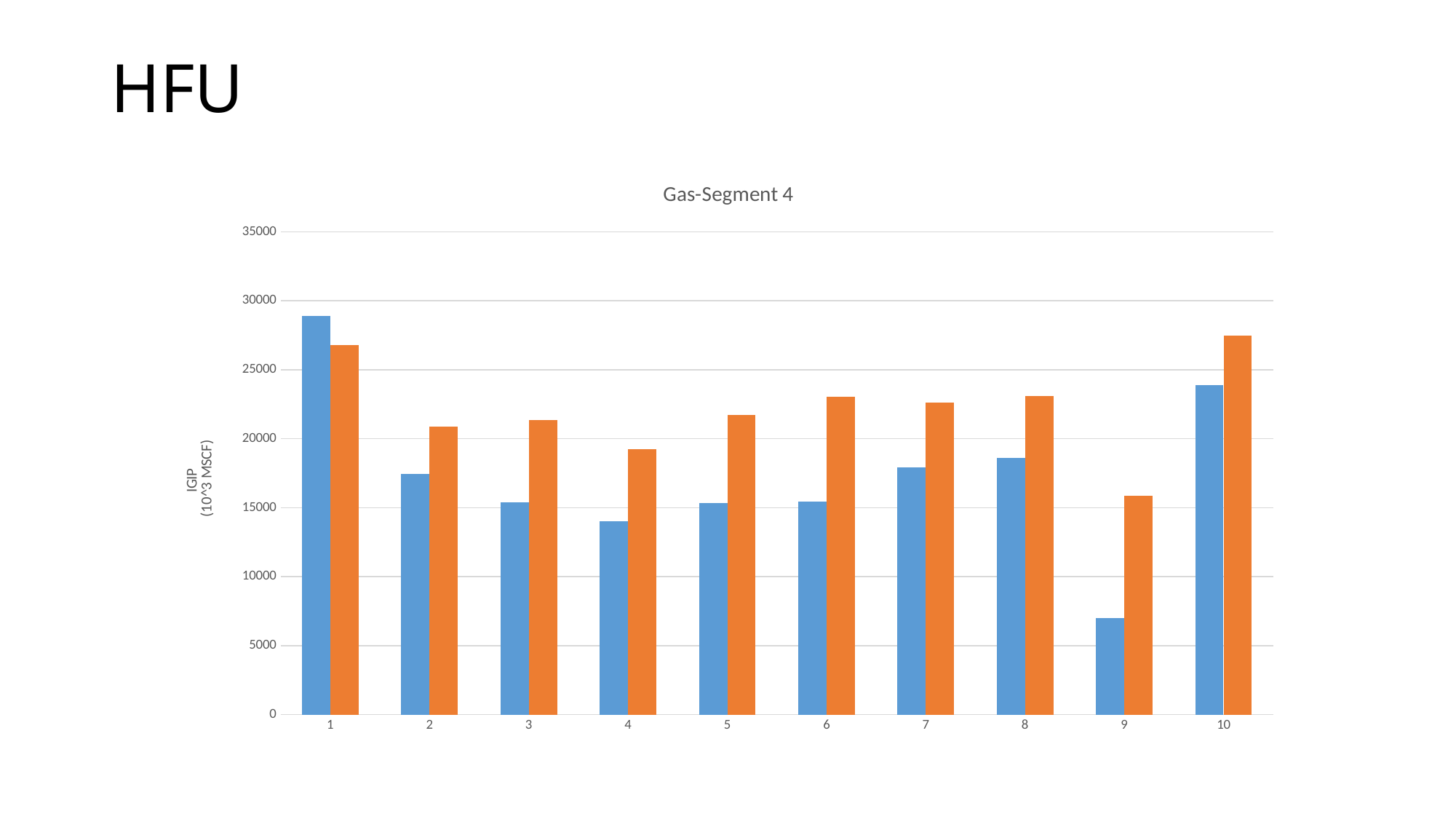
What is the label on the vertical axis of the chart? IGIP (10^3 MSCF) For category 1, which bar is taller, the blue bar or the orange bar? the blue bar How many categories are shown along the x axis of the chart? 10 Is the orange bar for category 10 greater or less than 25000? greater For which category is the orange bar the lowest? 9 Is the blue bar for category 4 greater or less than 15000? less What is the title of the chart? Gas-Segment 4 Is the blue bar for category 9 greater or less than 10000? less For which category is the blue bar the lowest? 9 What type of chart is shown on the slide? bar chart For which category is the blue bar the highest? 1 For category 9, which bar is taller, the blue bar or the orange bar? the orange bar